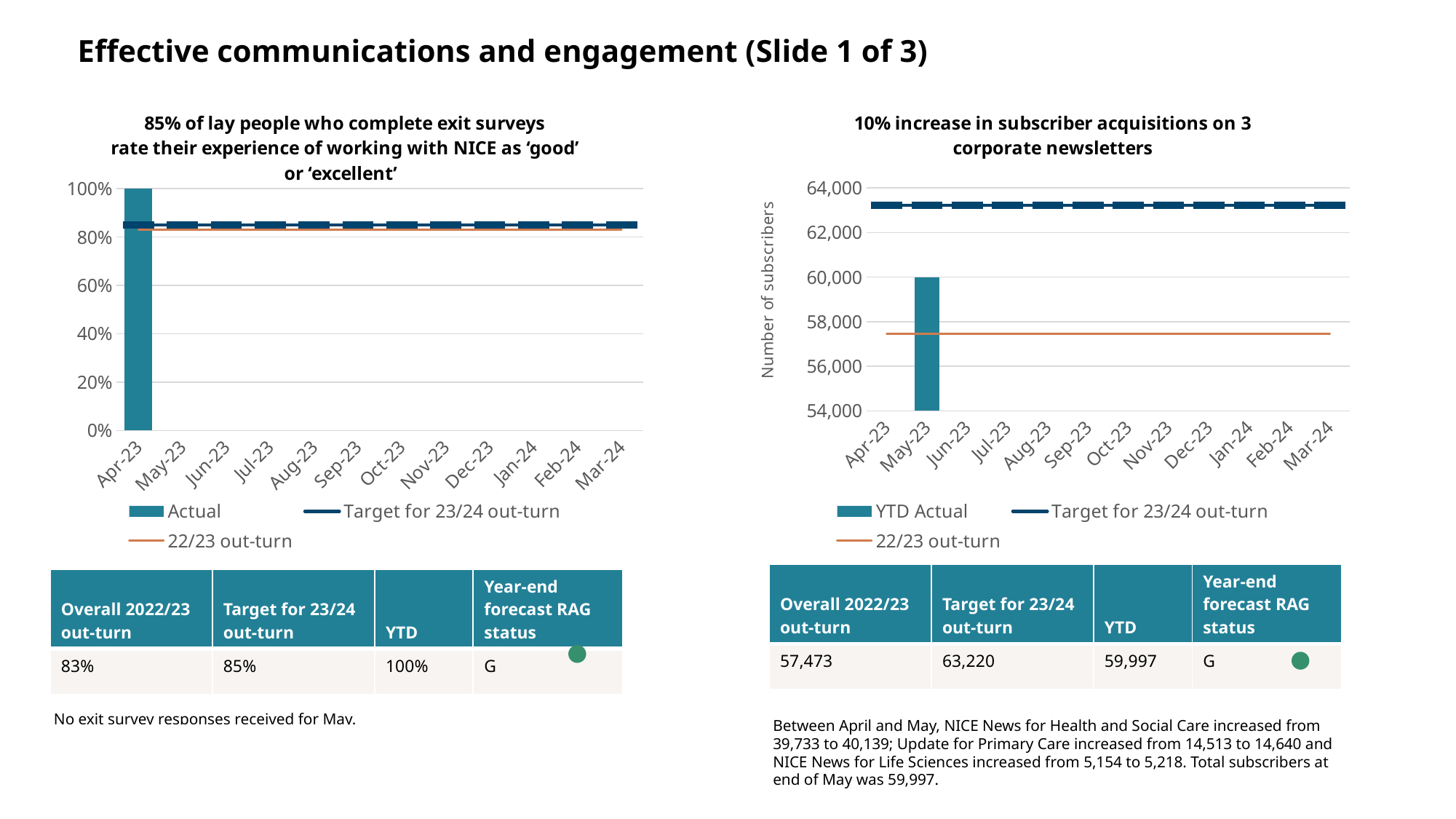
In the right chart (subscriber acquisitions), which line is higher: the Target for 23/24 out-turn or the 22/23 out-turn? Target for 23/24 out-turn In the right chart (subscriber acquisitions), which month has a YTD Actual bar plotted? May-23 In the left chart (exit surveys), what is the Actual value for Apr-23? 100% How many series does the legend of the left chart (exit surveys) list? 3 What is the y-axis title of the right chart (subscriber acquisitions)? Number of subscribers In the right chart (subscriber acquisitions), is the YTD Actual value for May-23 greater or less than 58,000? greater How many months are shown on the x axis of the left chart (exit surveys)? 12 In the left chart (exit surveys), which line is higher: the Target for 23/24 out-turn or the 22/23 out-turn? Target for 23/24 out-turn In the right chart (subscriber acquisitions), is the YTD Actual value for May-23 greater or less than 62,000? less What type of chart is the right chart titled '10% increase in subscriber acquisitions on 3 corporate newsletters'? combination bar and line chart What type of chart is the left chart titled '85% of lay people who complete exit surveys rate their experience of working with NICE as ‘good’ or ‘excellent’'? combination bar and line chart How many series does the legend of the right chart (subscriber acquisitions) list? 3